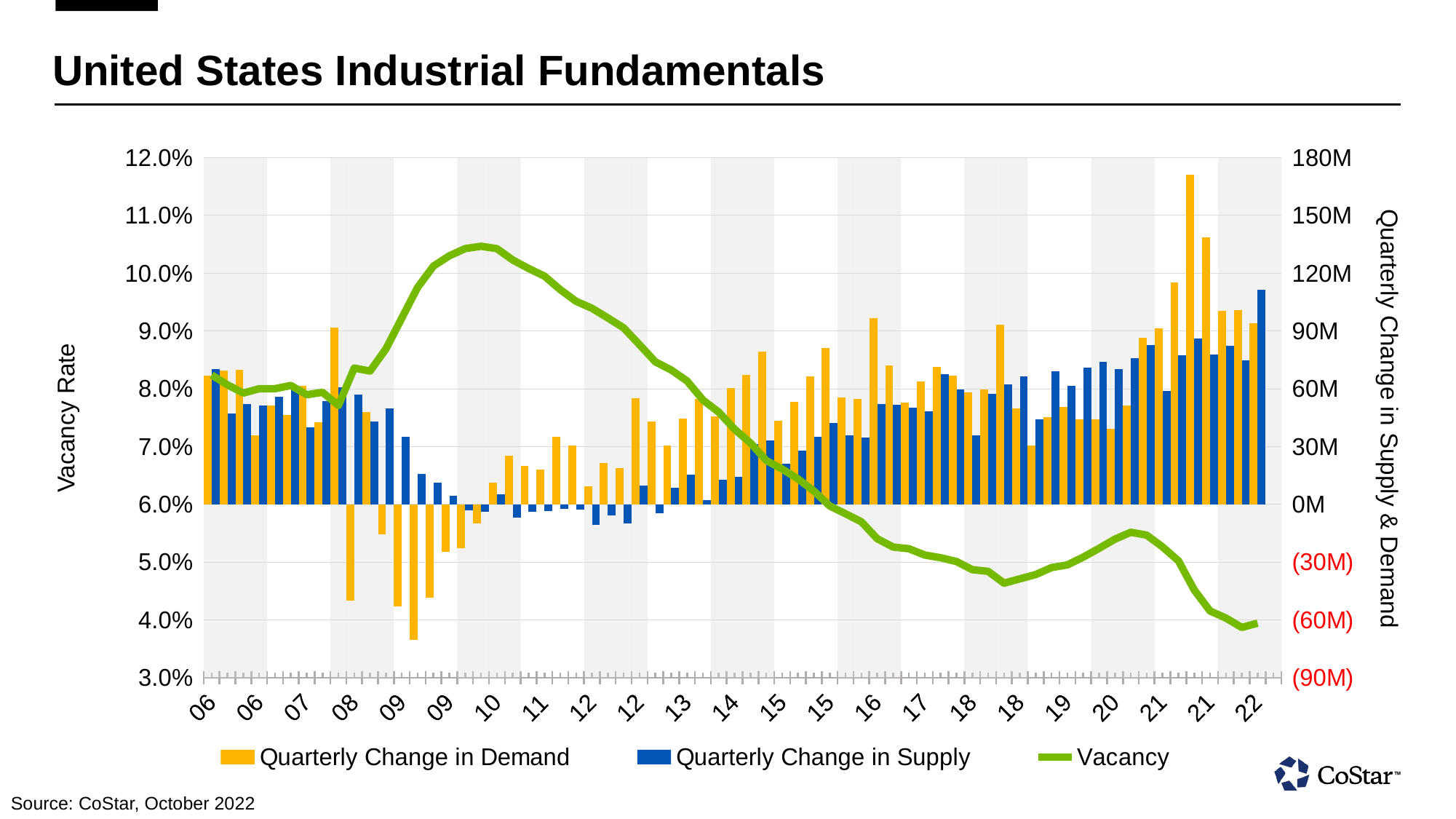
How many series does the legend list? 3 Is the Quarterly Change in Supply bar at the last point (22) greater or less than 90M? greater Around which year label does the Vacancy line reach its highest point? 10 Is the Vacancy value at the end of the series (22) greater or less than 5.0%? less At the last point (22), which bar is taller: Quarterly Change in Demand or Quarterly Change in Supply? Quarterly Change in Supply What is the title of the chart on the slide? United States Industrial Fundamentals Is the peak value of the Vacancy line around 2010 greater or less than 10.0%? greater Does the Vacancy line rise or fall between the 2010 peak and 2018? fall Which series is plotted as a line rather than bars? Vacancy Around which year label does the Vacancy line reach its lowest point? 22 What kind of chart is shown on the slide? A combination bar and line chart